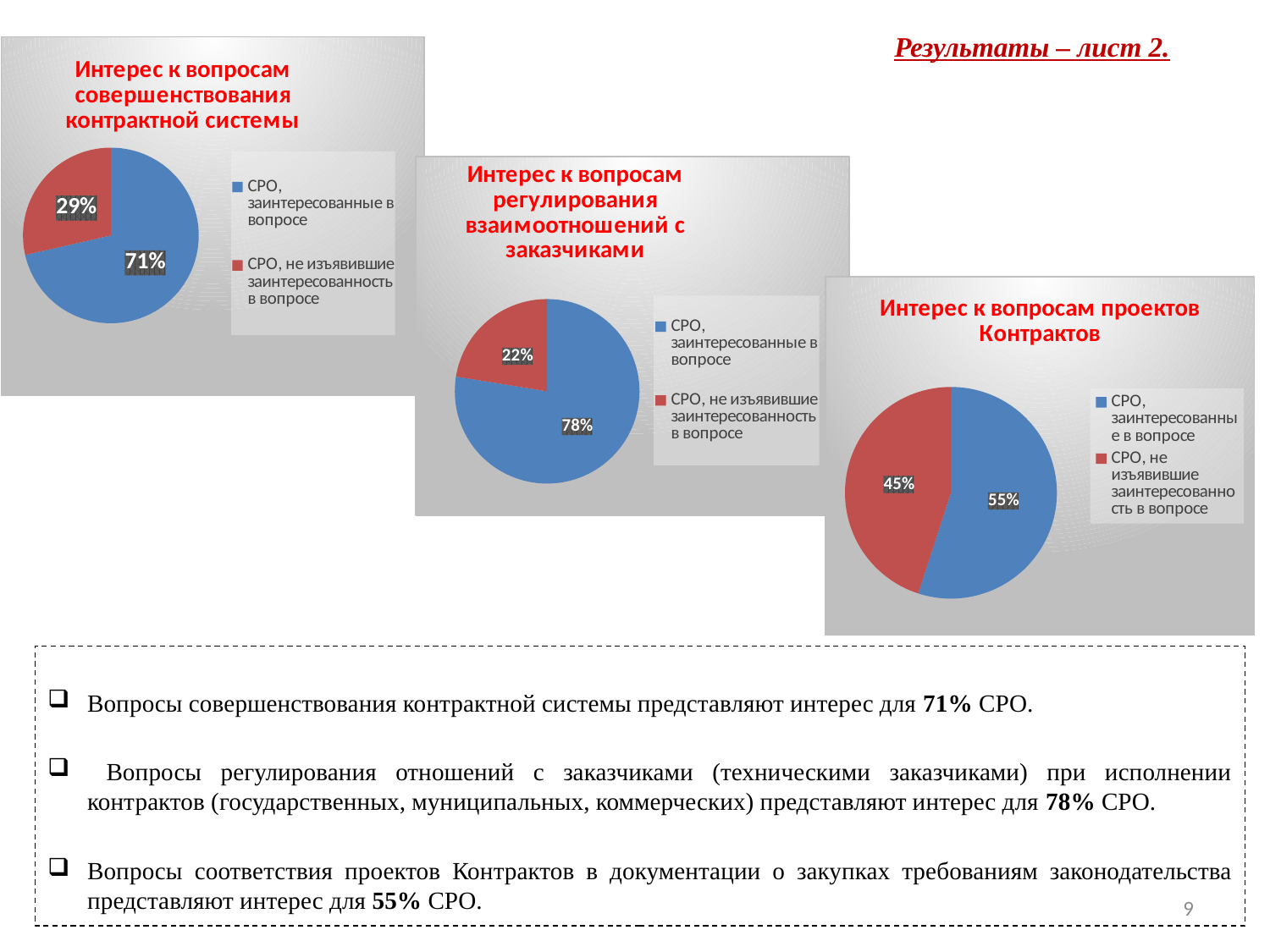
In the chart titled "Интерес к вопросам регулирования взаимоотношений с заказчиками", which category has the smaller share? СРО, не изъявившие заинтересованность в вопросе What type of chart is the chart titled "Интерес к вопросам регулирования взаимоотношений с заказчиками"? Pie chart In the chart titled "Интерес к вопросам проектов Контрактов", what is the difference between the two slices? 10% In the chart titled "Интерес к вопросам совершенствования контрактной системы", what share is shown for "СРО, не изъявившие заинтересованность в вопросе"? 29% In the chart titled "Интерес к вопросам совершенствования контрактной системы", what share is shown for "СРО, заинтересованные в вопросе"? 71% In the chart titled "Интерес к вопросам проектов Контрактов", what share is shown for "СРО, не изъявившие заинтересованность в вопросе"? 45% How many slices does the chart titled "Интерес к вопросам проектов Контрактов" have? 2 In the chart titled "Интерес к вопросам проектов Контрактов", which category has the larger share? СРО, заинтересованные в вопросе In the chart titled "Интерес к вопросам проектов Контрактов", what share is shown for "СРО, заинтересованные в вопросе"? 55% In the chart titled "Интерес к вопросам регулирования взаимоотношений с заказчиками", what share is shown for "СРО, заинтересованные в вопросе"? 78% In the chart titled "Интерес к вопросам совершенствования контрактной системы", what is the difference between the two slices? 42% In the chart titled "Интерес к вопросам регулирования взаимоотношений с заказчиками", what share is shown for "СРО, не изъявившие заинтересованность в вопросе"? 22%